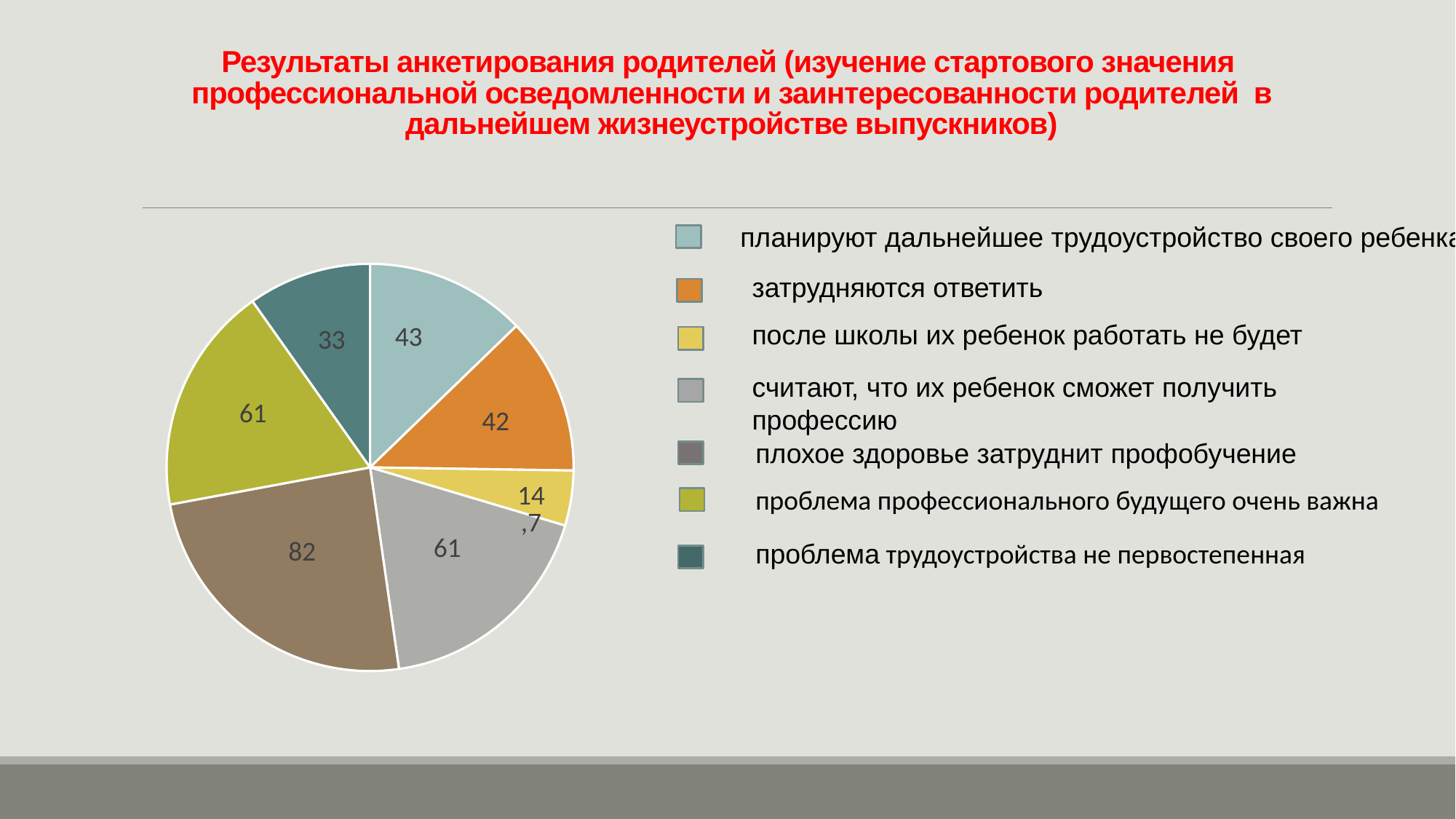
What is the value for "затрудняются ответить"? 42 What is the value for "планируют дальнейшее трудоустройство своего ребенка"? 43 Which category has the largest slice of the pie? плохое здоровье затруднит профобучение What is the value for "после школы их ребенок работать не будет"? 14,7 Which is larger: the value for "считают, что их ребенок сможет получить профессию" or the value for "затрудняются ответить"? считают, что их ребенок сможет получить профессию What is the value for "проблема трудоустройства не первостепенная"? 33 What is the difference between the values for "плохое здоровье затруднит профобучение" and "проблема трудоустройства не первостепенная"? 49 How many entries does the legend list? 7 How many slices does the pie chart have? 7 What kind of chart is shown on the slide? pie chart What is the value for "плохое здоровье затруднит профобучение"? 82 Which category has the smallest slice of the pie? после школы их ребенок работать не будет